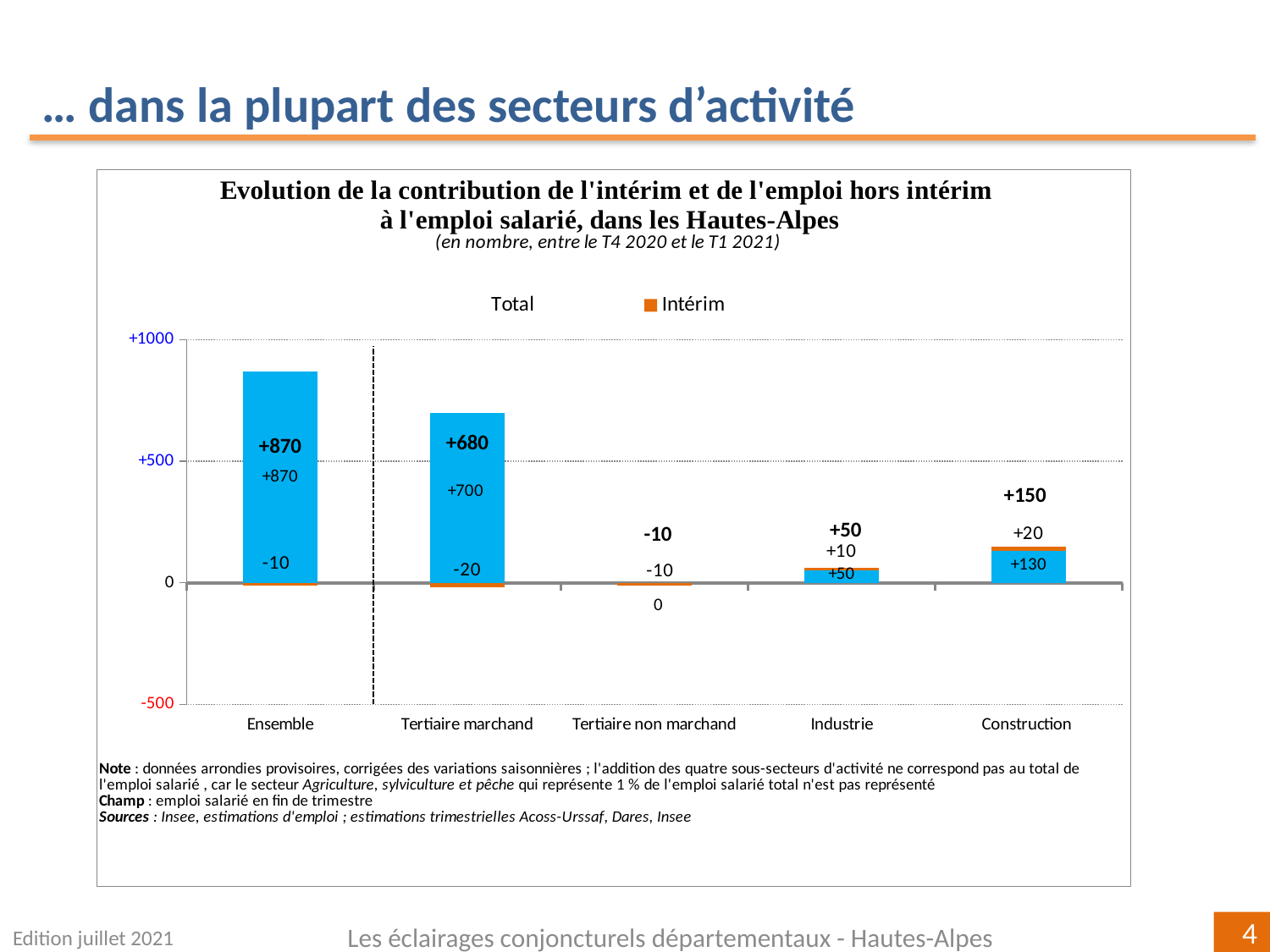
What is the value of the blue bar segment for Construction? +130 What is the bold total value shown for Construction? +150 Which entries are listed in the chart legend? Total, Intérim What is the difference between the bold total values for Ensemble and Tertiaire marchand? 190 What is the Intérim value shown for Tertiaire marchand? -20 Which has the larger bold total value, Industrie or Construction? Construction What is the Intérim value shown for Industrie? +10 What kind of chart is shown on the slide? bar chart What is the bold total value shown for Ensemble? +870 Which category has the lowest bold total value? Tertiaire non marchand Which category has the highest bold total value? Ensemble How many sector categories are shown on the x axis? 5